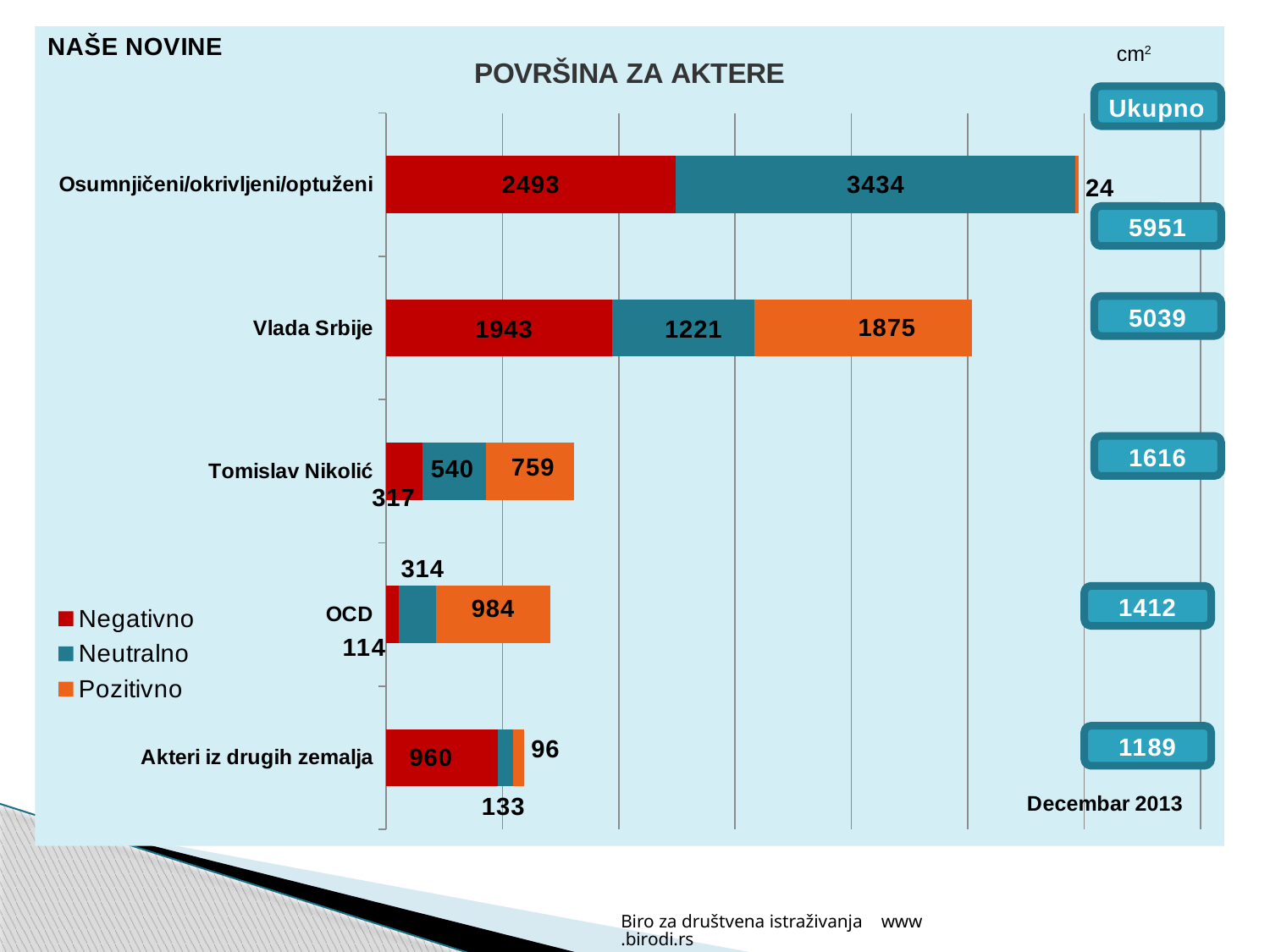
How many series does the legend list? 3 What is the total (Ukupno) value for Tomislav Nikolić? 1616 Which actor has the lowest total (Ukupno) value? Akteri iz drugih zemalja What is the Pozitivno value for Akteri iz drugih zemalja? 96 What is the Negativno value for Osumnjičeni/okrivljeni/optuženi? 2493 Which is larger for Vlada Srbije: the Negativno value or the Pozitivno value? Negativno What is the difference between the Neutralno and Negativno values for Osumnjičeni/okrivljeni/optuženi? 941 How many categories (actors) are plotted in the chart? 5 What kind of chart is shown on the slide? stacked bar chart What is the Pozitivno value for OCD? 984 What is the Neutralno value for Vlada Srbije? 1221 Which actor has the highest total (Ukupno) value? Osumnjičeni/okrivljeni/optuženi